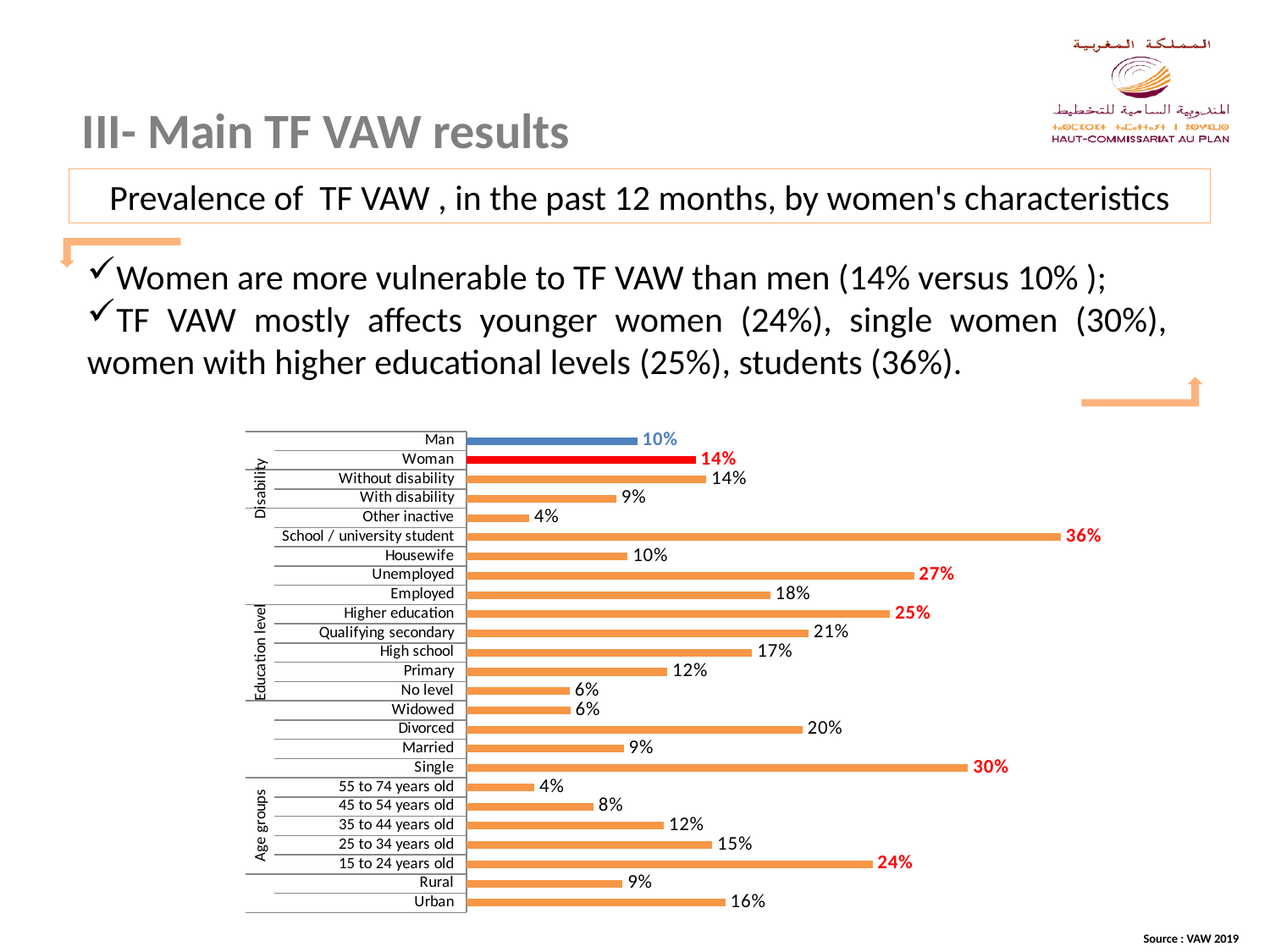
What is the value shown for single women? 30% Do the values rise or fall as the age groups go from 15 to 24 years old to 55 to 74 years old? fall Which category has the highest value in the chart? School / university student What is the value shown for Rural? 9% Which has a larger value, Unemployed or Employed? Unemployed What is the value shown for the 15 to 24 years old age group? 24% Which has a larger value, Divorced or Married? Divorced How many categories are plotted in the chart? 25 What is the difference between the values for Woman and Man? 4% What kind of chart is shown on the slide? bar chart What is the difference between the values for Urban and Rural? 7% What is the prevalence of TF VAW for school / university students? 36%